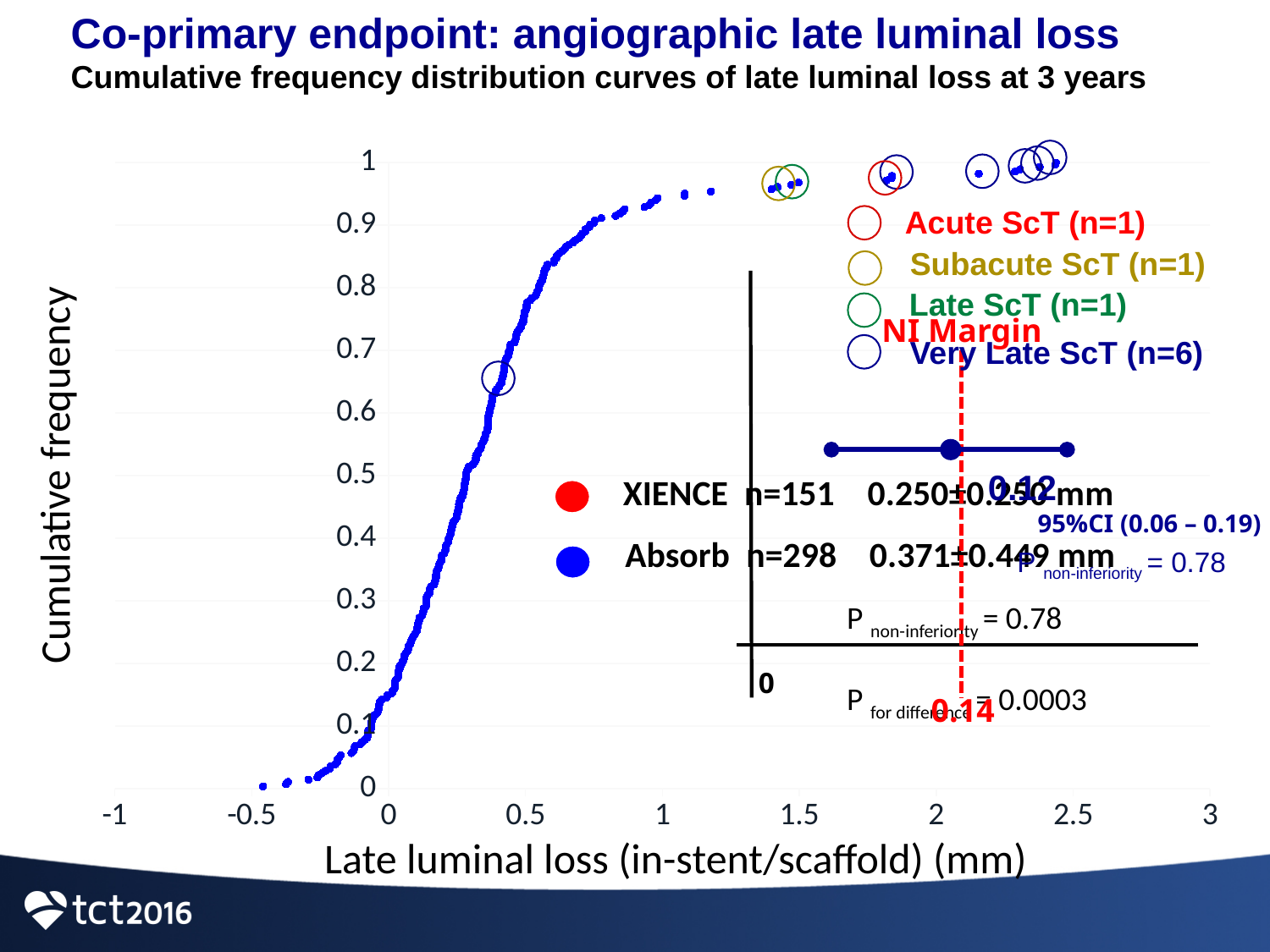
Which group has more patients, XIENCE or Absorb? Absorb How many Very Late ScT events are listed in the legend? 6 What is the difference in the number of patients between the Absorb and XIENCE groups? 147 What is the P value for non-inferiority? 0.78 What is the title of the y axis? Cumulative frequency What kind of chart is shown on the slide? scatter chart How many patients (n) are in the XIENCE group? 151 What is the late luminal loss reported for Absorb? 0.371±0.449 mm How many patients (n) are in the Absorb group? 298 What is the late luminal loss reported for XIENCE? 0.250±0.250 mm What is the title of the x axis? Late luminal loss (in-stent/scaffold) (mm) Does the cumulative frequency rise or fall as late luminal loss increases along the x axis? rise